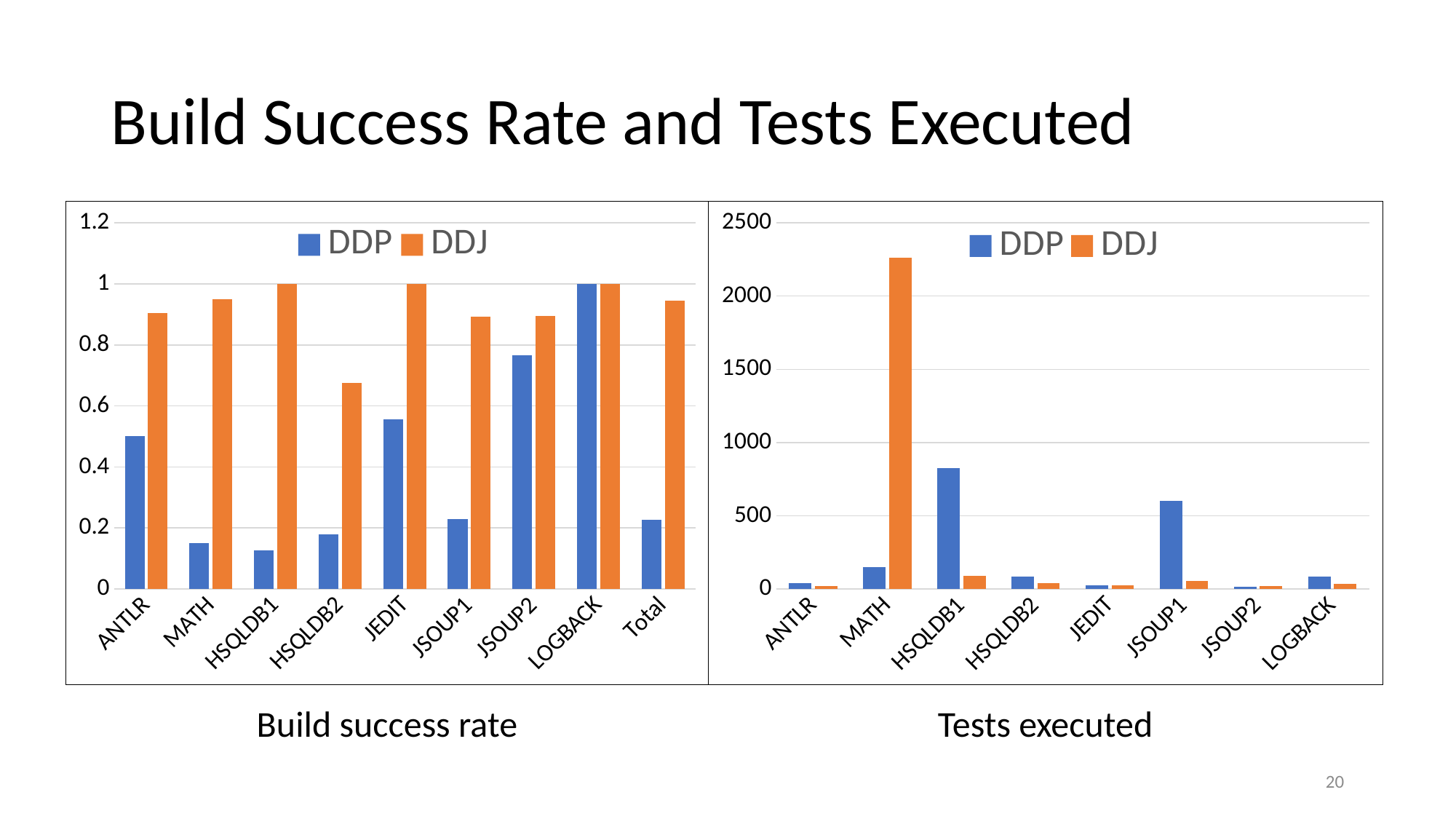
How many categories are shown on the x axis of the Build success rate chart? 9 In the Tests executed chart, is the DDJ value for MATH greater or less than 2000? greater In the Build success rate chart, what is the DDJ value for HSQLDB1? 1 In the Build success rate chart, is the DDP value for JSOUP2 greater or less than 0.6? greater In the Tests executed chart, which is larger for HSQLDB1, the DDP value or the DDJ value? DDP In the Build success rate chart, which category has the lowest DDJ value? HSQLDB2 How many categories are shown on the x axis of the Tests executed chart? 8 In the Build success rate chart, what is the DDP value for LOGBACK? 1 In the Tests executed chart, which category has the highest DDP value? HSQLDB1 How many series does the legend of the Tests executed chart list? 2 In the Tests executed chart, which category has the highest DDJ value? MATH What kind of chart is the Build success rate chart? bar chart